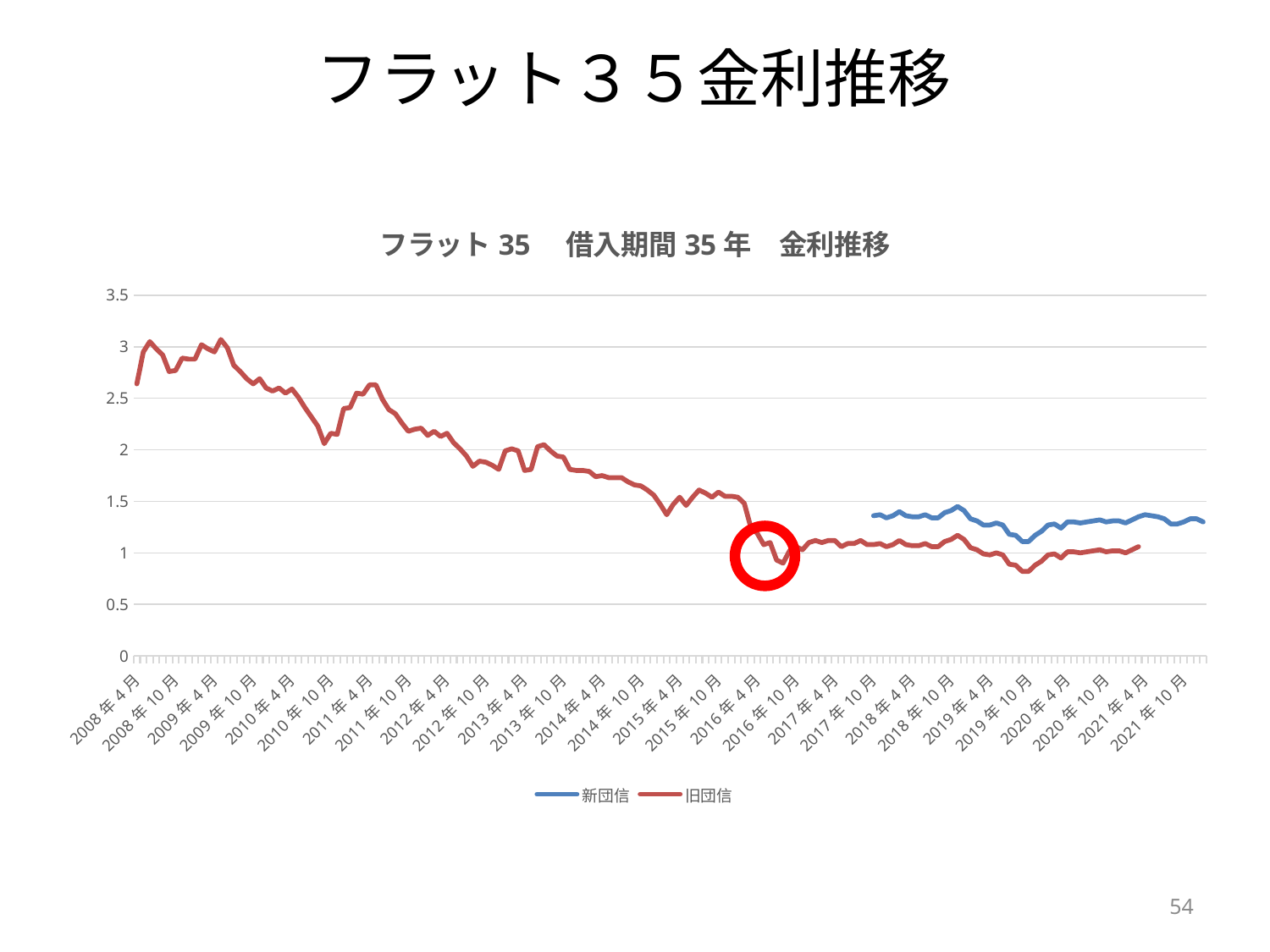
Which series is drawn in blue? 新団信 What is the title of the chart? フラット35 借入期間35年 金利推移 Is the value for 旧団信 at 2019年10月 greater or less than 1? less Is the value for 新団信 at 2018年10月 greater or less than 1? greater How many series does the legend list? 2 Does the 旧団信 line generally rise or fall from 2008年4月 to 2021年10月? fall What kind of chart is shown on the slide? line chart Which series reaches the highest value anywhere on the chart? 旧団信 Which series reaches the lowest value anywhere on the chart? 旧団信 Is the value for 旧団信 at 2013年4月 greater or less than 2.5? less At 2020年4月, which series has the higher value, 新団信 or 旧団信? 新団信